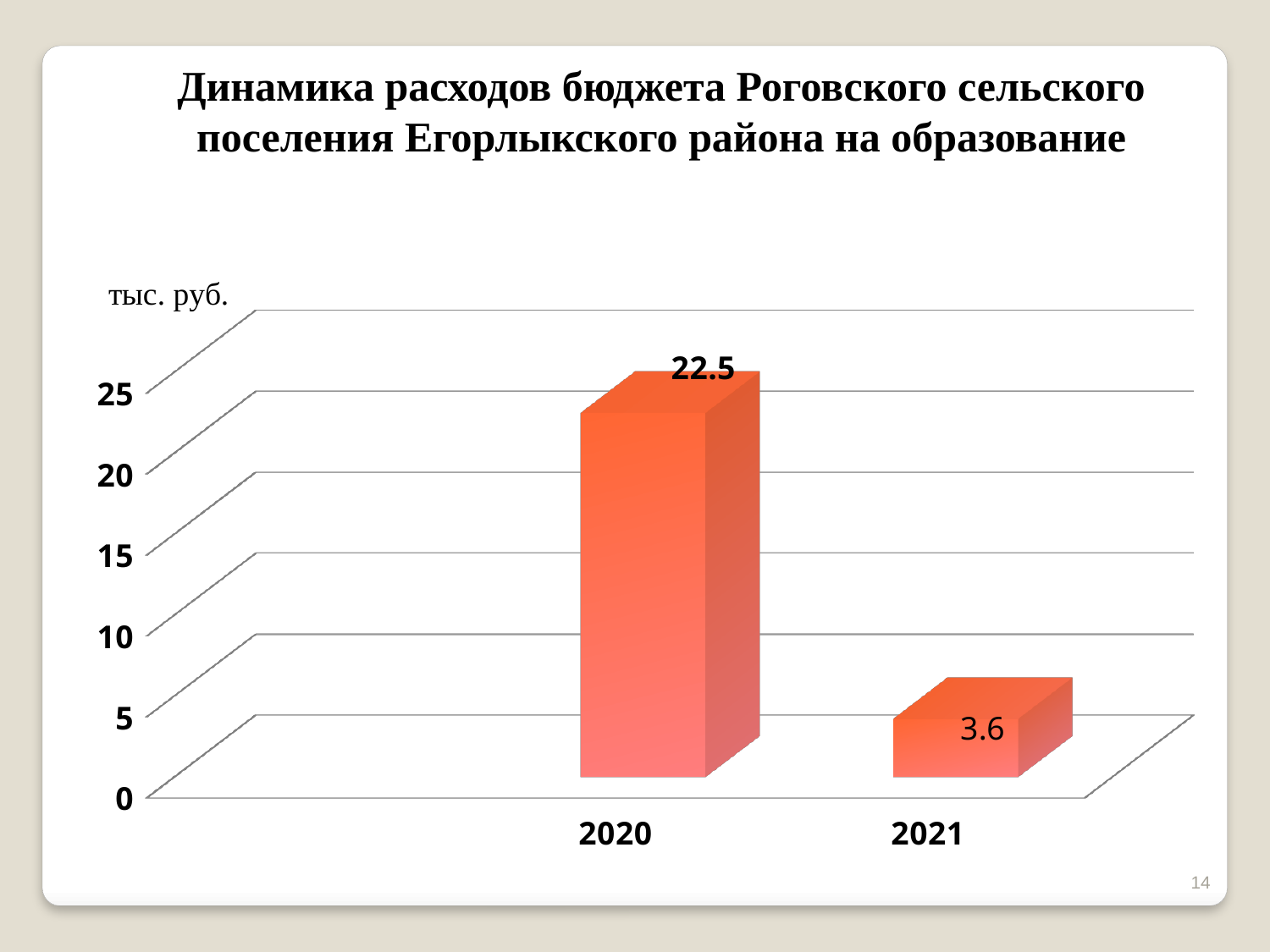
What is the value for 2020? 22.5 Do the values rise or fall from 2020 to 2021? fall What kind of chart is shown on the slide? bar chart What is the value for 2021? 3.6 Which year has the highest value? 2020 What is the difference between the values for 2020 and 2021? 18.9 Is the value for 2020 greater or less than 20? greater How many years are shown on the chart? 2 What unit is shown on the chart's axis label? тыс. руб. Which year has the lowest value? 2021 Which is larger, the value for 2020 or the value for 2021? 2020 Is the value for 2021 greater or less than 5? less